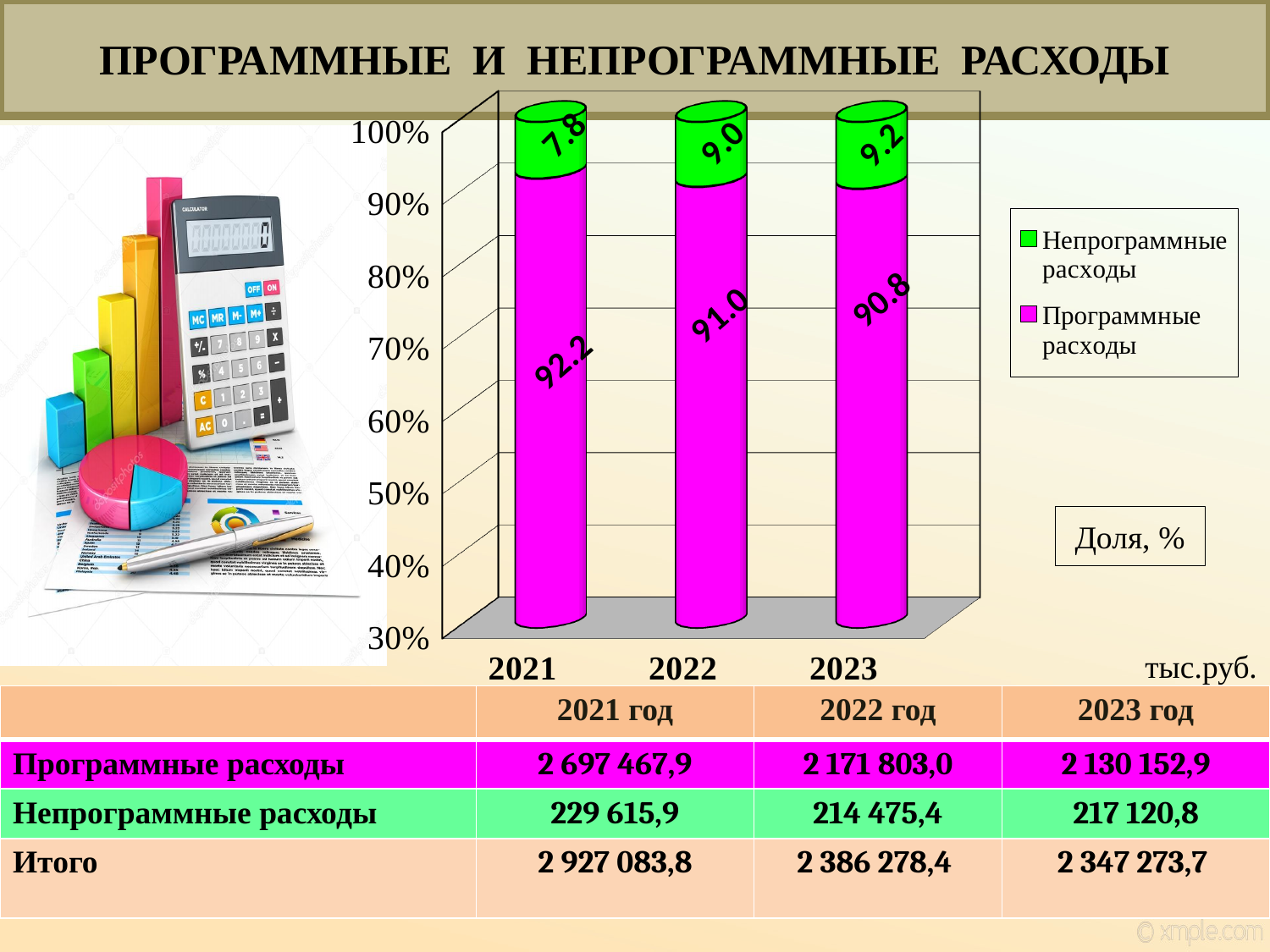
What is the share of Программные расходы in 2021 on the chart? 92.2 How many series does the chart legend list? 2 How many years are shown on the x axis of the chart? 3 What is the share of Непрограммные расходы in 2023 on the chart? 9.2 What is the difference between the share of Непрограммные расходы in 2023 and in 2021? 1.4 In which year is the share of Непрограммные расходы the lowest? 2021 Does the share of Непрограммные расходы rise or fall from 2021 to 2023? Rise Which colour represents Программные расходы in the chart legend? Magenta What kind of chart is shown on the slide? Stacked bar chart Which is larger: the share of Программные расходы in 2022 or in 2023? 2022 In which year is the share of Программные расходы the highest? 2021 What is the share of Программные расходы in 2022 on the chart? 91.0